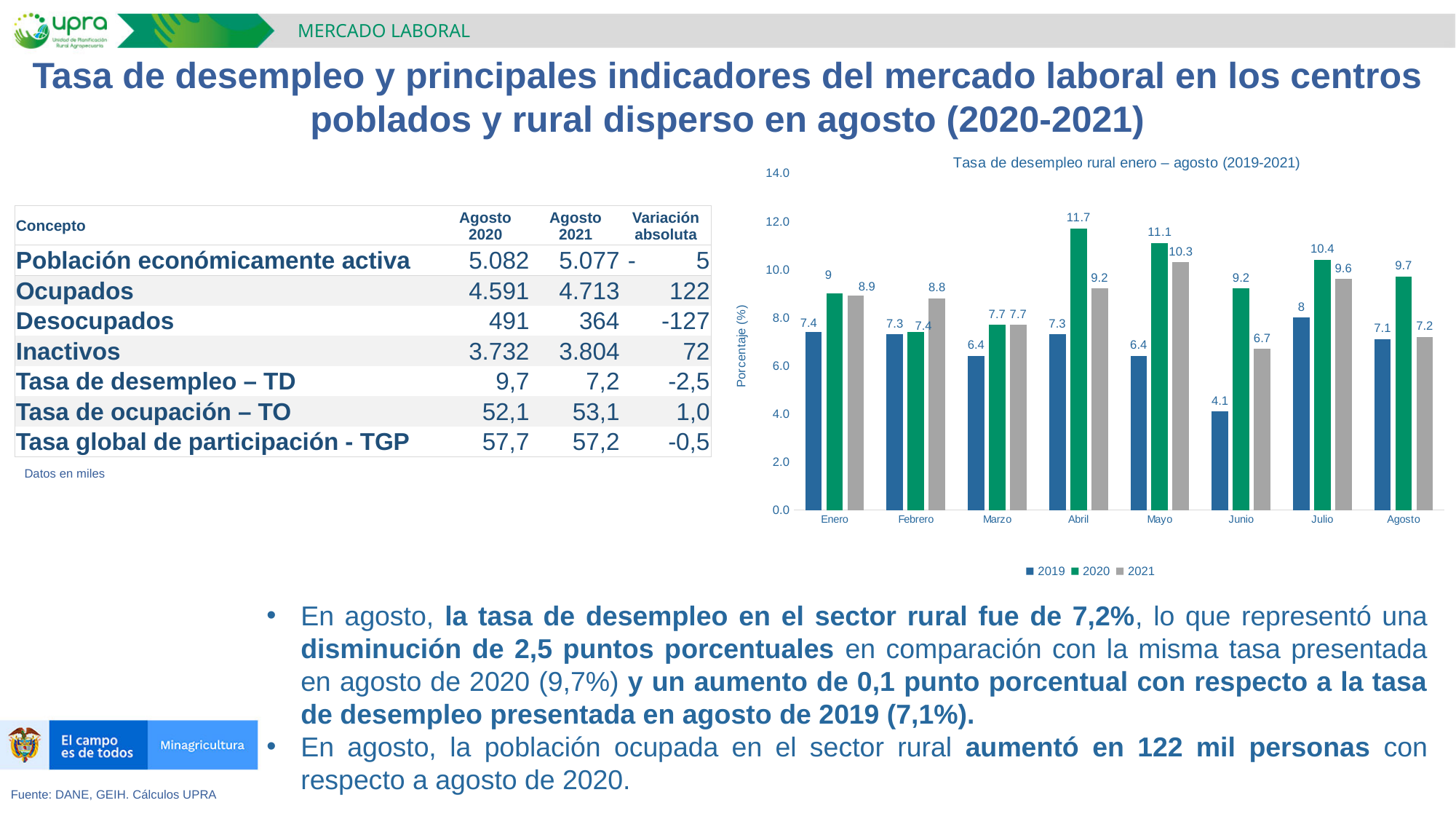
What is the 2020 value for Abril in the chart? 11.7 What is the title of the chart? Tasa de desempleo rural enero – agosto (2019-2021) Which month has the highest 2020 value in the chart? Abril What is the difference between the 2020 and 2021 values for Agosto? 2.5 How many months are shown on the x axis of the chart? 8 What is the 2019 value for Junio in the chart? 4.1 Which is larger for Febrero: the 2020 value or the 2021 value? 2021 What type of chart is shown on the slide? Bar chart Which month has the lowest 2019 value in the chart? Junio How many series does the chart legend list? 3 What is the label of the y axis of the chart? Porcentaje (%) What is the 2021 value for Mayo in the chart? 10.3